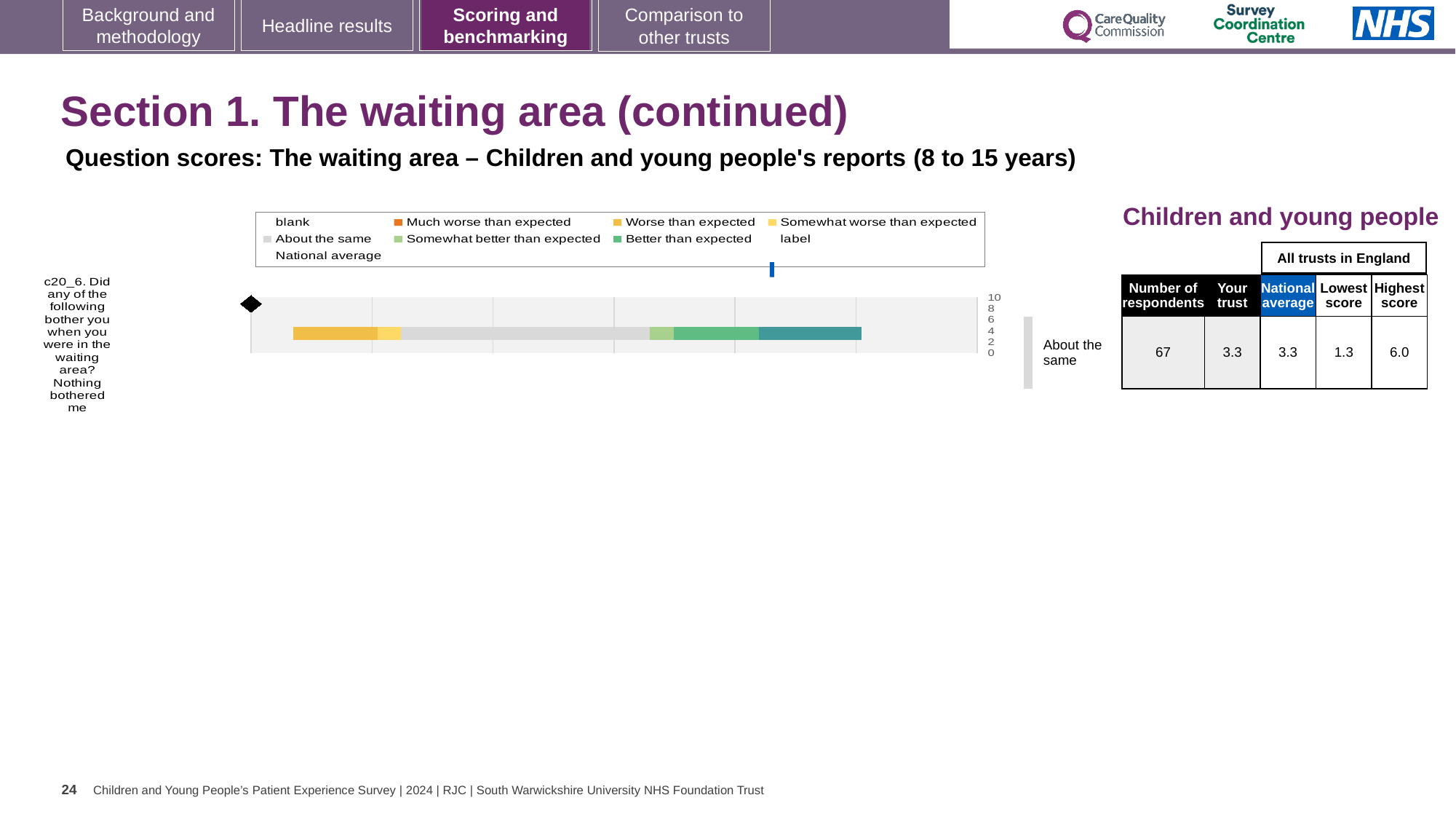
Which is larger for question c20_6: the highest score across all trusts or the national average? the highest score In the table beside the chart, what is the 'Your trust' score for question c20_6? 3.3 How many survey questions are plotted in the chart? 1 In the table beside the chart, what is the highest score across all trusts in England for question c20_6? 6.0 In the table beside the chart, what is the national average score for question c20_6? 3.3 What benchmark category label is shown to the right of the chart for question c20_6? About the same What is the difference between the national average (3.3) and the lowest score (1.3) in the table for question c20_6? 2.0 What kind of chart is used to show the question score for c20_6? bar chart What is the question code of the item plotted in the chart? c20_6 What is the difference between the highest score (6.0) and the lowest score (1.3) shown in the table for question c20_6? 4.7 In the table beside the chart, what is the lowest score across all trusts in England for question c20_6? 1.3 In the table beside the chart, how many respondents answered question c20_6? 67